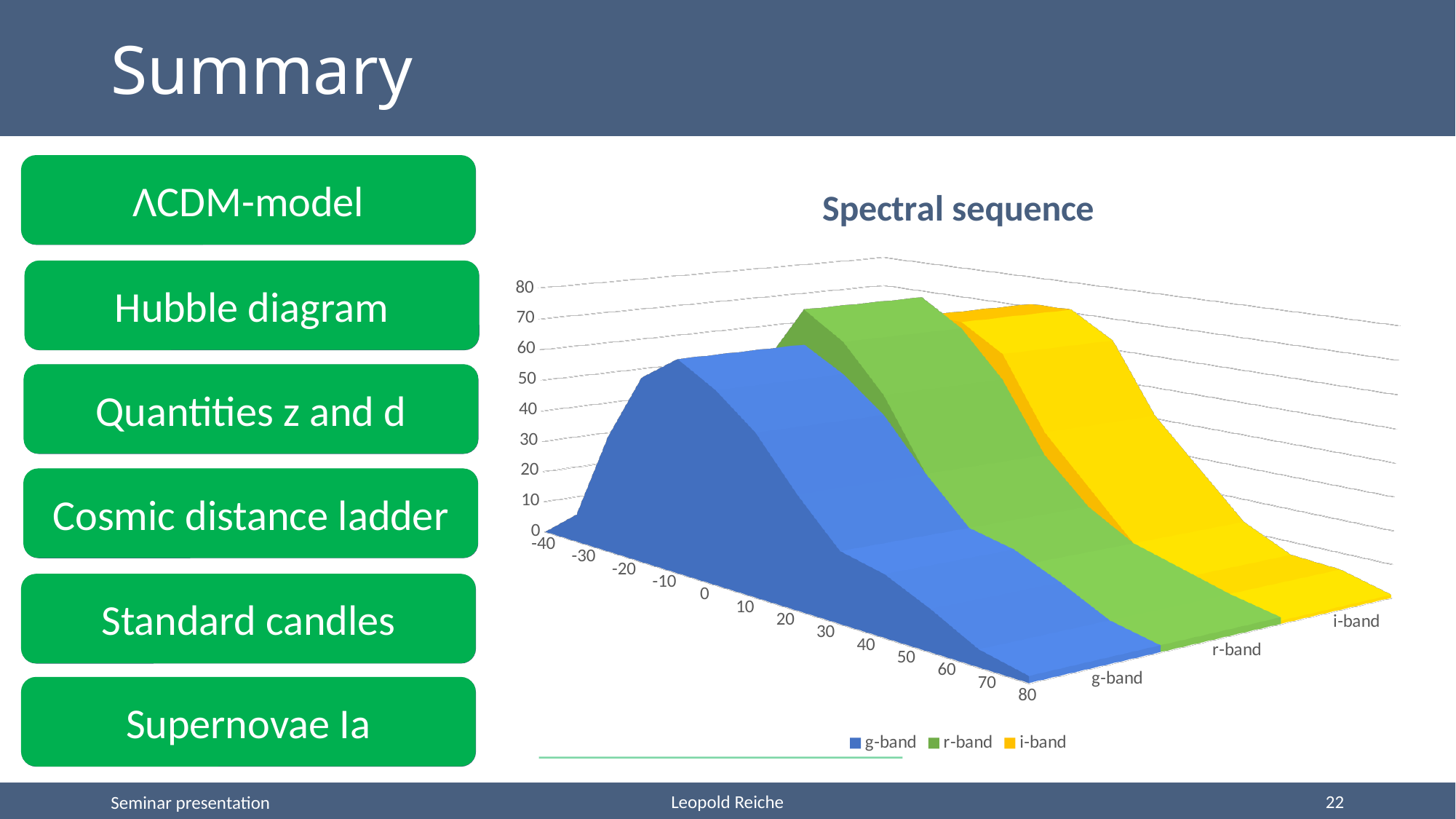
What kind of chart is shown on the slide? Area chart What is the highest value labelled on the vertical axis? 80 How many tick labels are shown on the x axis of the chart? 13 Does the g-band series rise or fall between x = -40 and x = 0? Rise Does the g-band series rise or fall between x = 30 and x = 80? Fall Which series is plotted in blue? g-band Is the g-band value at x = -40 greater or less than 10? less What is the lowest value labelled on the x axis? -40 What is the title of the chart? Spectral sequence What is the highest value labelled on the x axis? 80 How many series does the chart legend list? 3 Which series is listed last in the legend? i-band